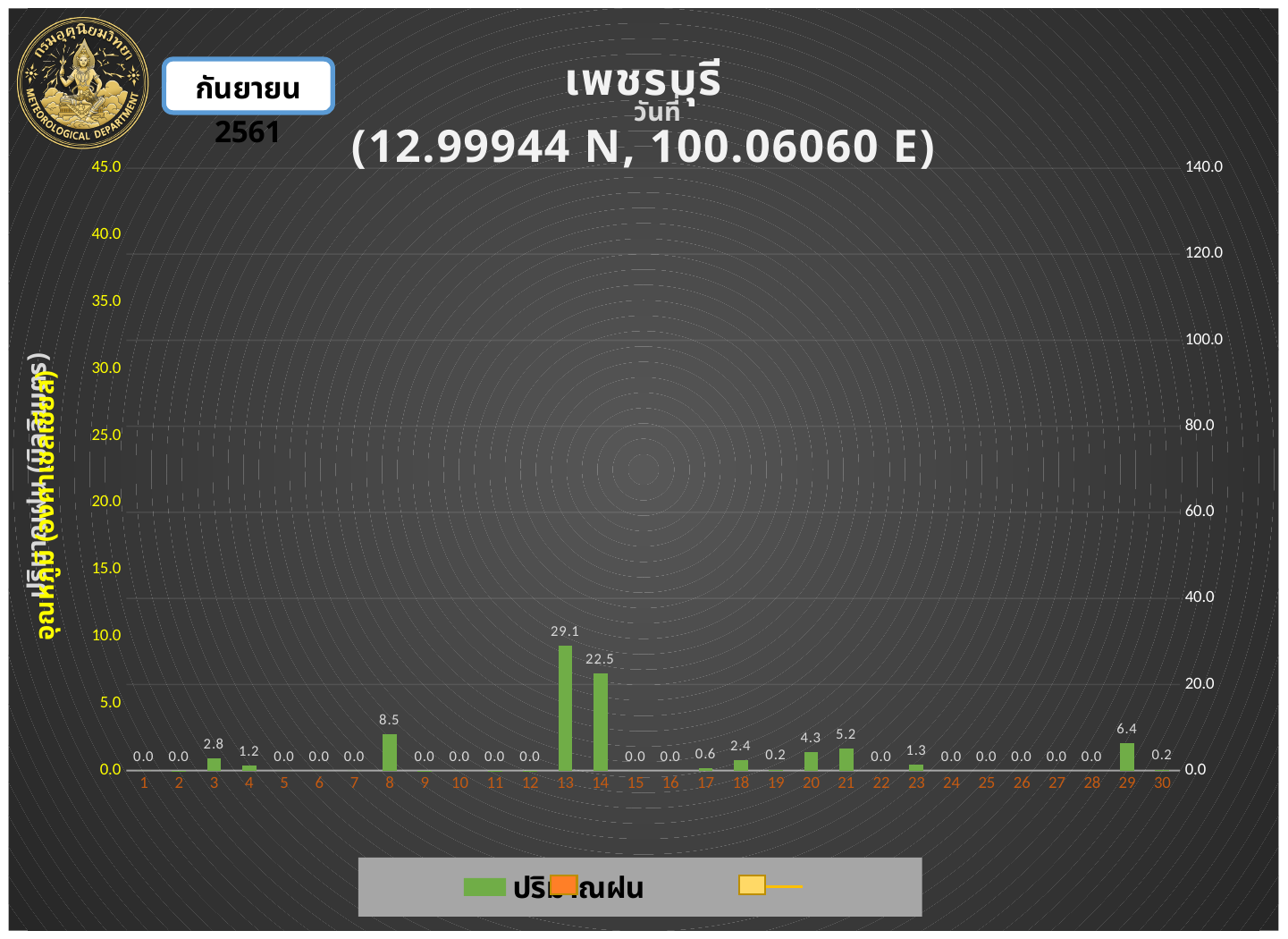
What is the difference between the rainfall values for day 13 and day 14? 6.6 What is the rainfall value shown for day 29? 6.4 What is the difference between the rainfall values for day 8 and day 29? 2.1 Which day has the larger rainfall value, day 20 or day 21? 21 What kind of chart is shown on the slide? bar chart What is the rainfall value shown for day 21? 5.2 What are the coordinates given in the chart title? 12.99944 N, 100.06060 E Which day has the larger rainfall value, day 3 or day 18? 3 How many days are shown on the x axis? 30 What is the rainfall value shown for day 13? 29.1 Which day has the highest rainfall value? 13 What is the rainfall value shown for day 8? 8.5